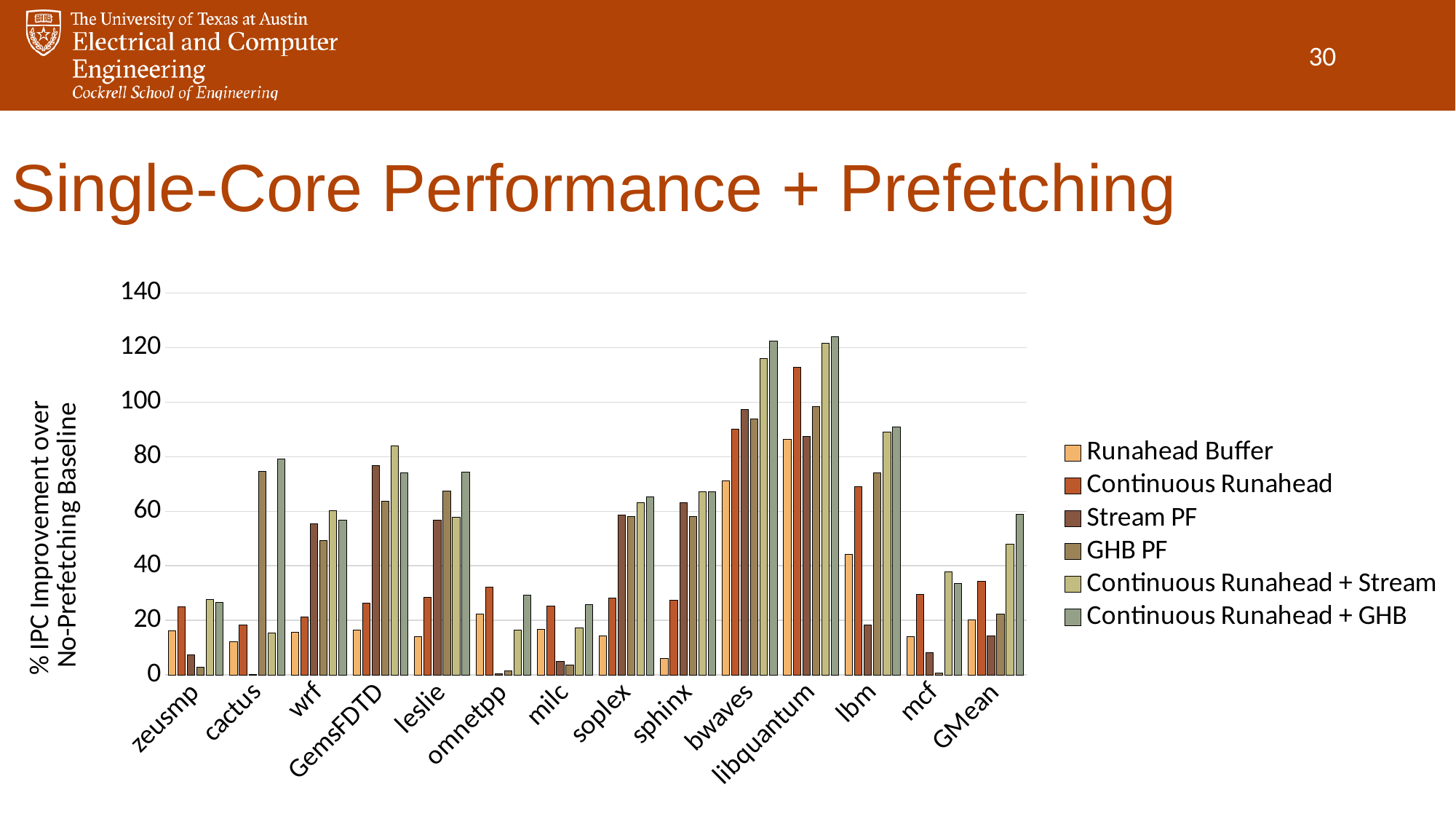
Which category has the highest Continuous Runahead bar? libquantum Is the Continuous Runahead + GHB value for GMean greater or less than 40? greater What kind of chart is shown on the slide? bar chart What is the label on the y axis? % IPC Improvement over No-Prefetching Baseline For cactus, which is larger: Stream PF or Runahead Buffer? Runahead Buffer Is the Runahead Buffer value for sphinx greater or less than 20? less For GMean, which is larger: Continuous Runahead + GHB or Continuous Runahead + Stream? Continuous Runahead + GHB How many categories are shown along the x axis? 14 Is the Continuous Runahead value for libquantum greater or less than 100? greater Which category has the highest Runahead Buffer bar? libquantum How many series does the legend list? 6